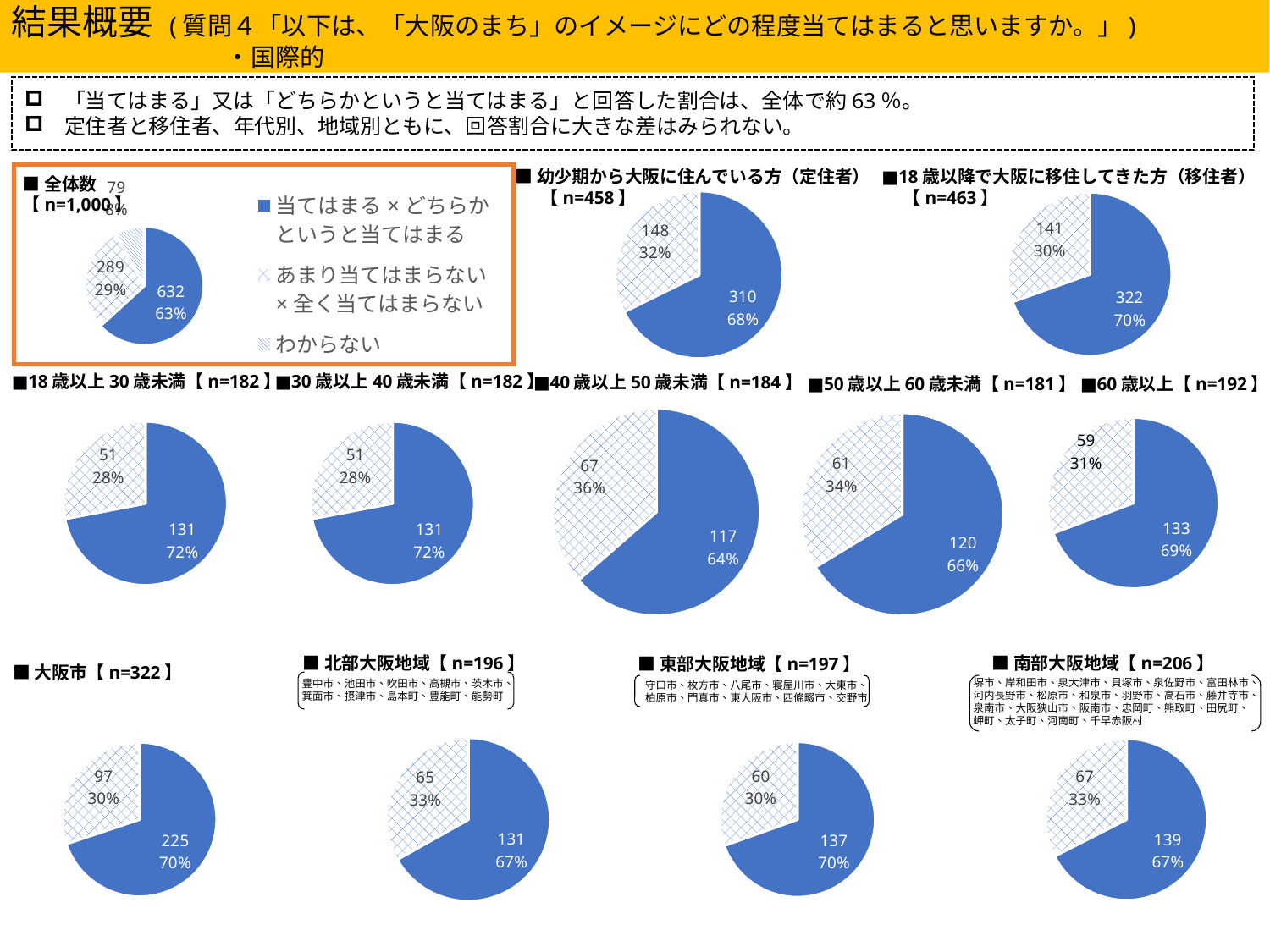
In the 幼少期から大阪に住んでいる方（定住者）【n=458】 pie chart, what percentage is shown for the smaller slice? 32% In the 全体数【n=1,000】 pie chart, what percentage is shown for the あまり当てはまらない × 全く当てはまらない slice? 29% In the 40歳以上50歳未満【n=184】 pie chart, what is the difference between the two slice values (117 and 67)? 50 How many entries does the legend next to the 全体数 pie chart list? 3 In the 東部大阪地域【n=197】 pie chart, what percentage is shown for the smaller slice? 30% In the 18歳以降で大阪に移住してきた方（移住者）【n=463】 pie chart, what is the value of the larger slice? 322 What type of chart is used for the 幼少期から大阪に住んでいる方（定住者）【n=458】 data? Pie chart In the 大阪市【n=322】 pie chart, what is the value shown for the larger slice? 225 Which pie chart shows a larger percentage for the larger slice: 18歳以上30歳未満【n=182】 or 40歳以上50歳未満【n=184】? 18歳以上30歳未満【n=182】 In the 全体数【n=1,000】 pie chart, what is the value shown for the 当てはまる × どちらかというと当てはまる slice? 632 In the 南部大阪地域【n=206】 pie chart, how many slices are shown? 2